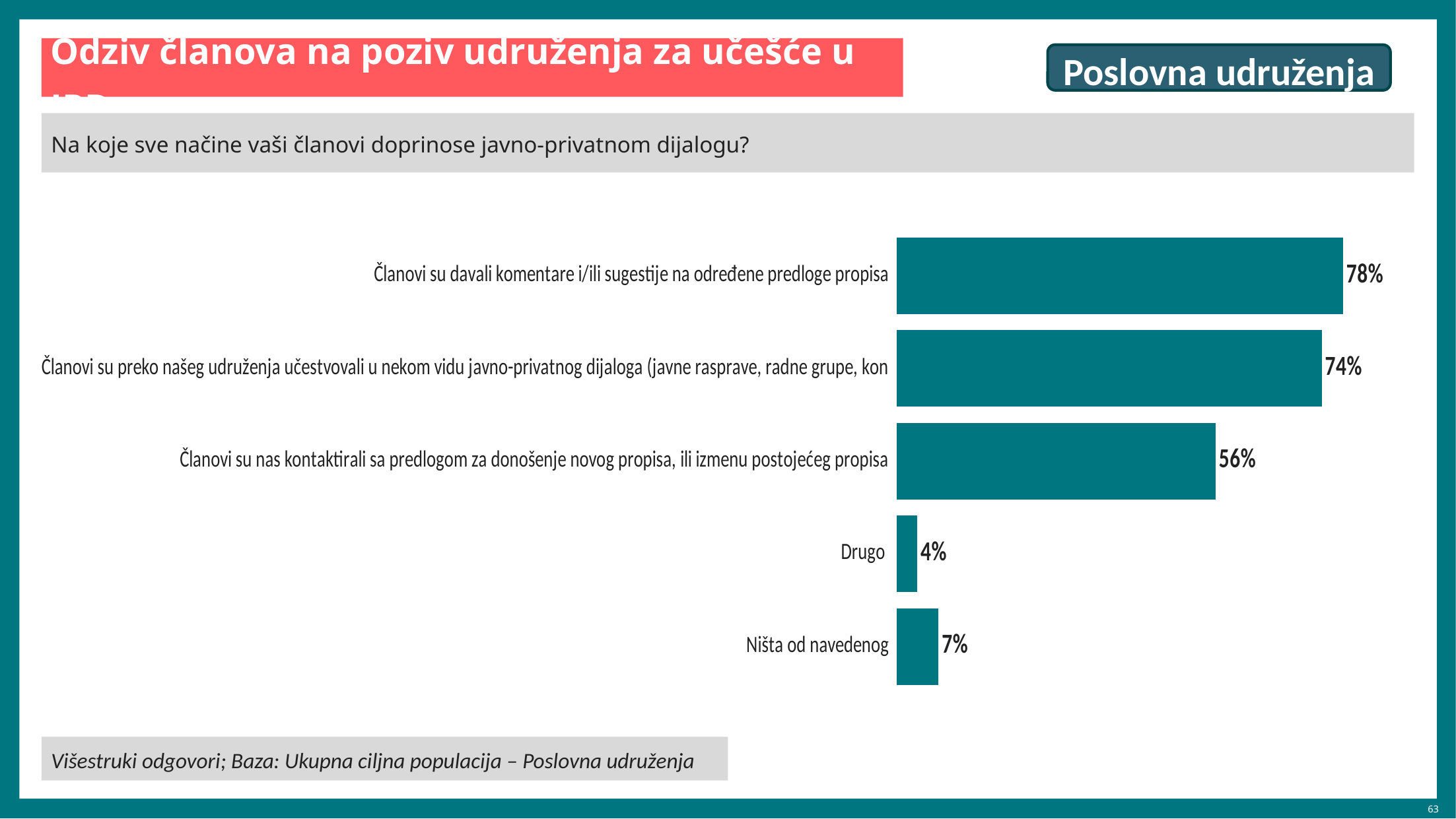
What is the value for "Ništa od navedenog"? 7% What percentage is shown for "Članovi su nas kontaktirali sa predlogom za donošenje novog propisa, ili izmenu postojećeg propisa"? 56% What is the difference between the values for "Članovi su davali komentare i/ili sugestije na određene predloge propisa" and "Članovi su nas kontaktirali sa predlogom za donošenje novog propisa, ili izmenu postojećeg propisa"? 22% What kind of chart is shown on the slide? Bar chart What percentage is shown for "Članovi su davali komentare i/ili sugestije na određene predloge propisa"? 78% Which is larger: the value for "Drugo" or the value for "Ništa od navedenog"? Ništa od navedenog How many categories are shown in the chart? 5 What question is the chart answering, as shown in the grey box above it? Na koje sve načine vaši članovi doprinose javno-privatnom dijalogu? What is the value for "Drugo"? 4% What is the difference between the values for "Ništa od navedenog" and "Drugo"? 3% Which category has the highest value? Članovi su davali komentare i/ili sugestije na određene predloge propisa Which category has the lowest value? Drugo